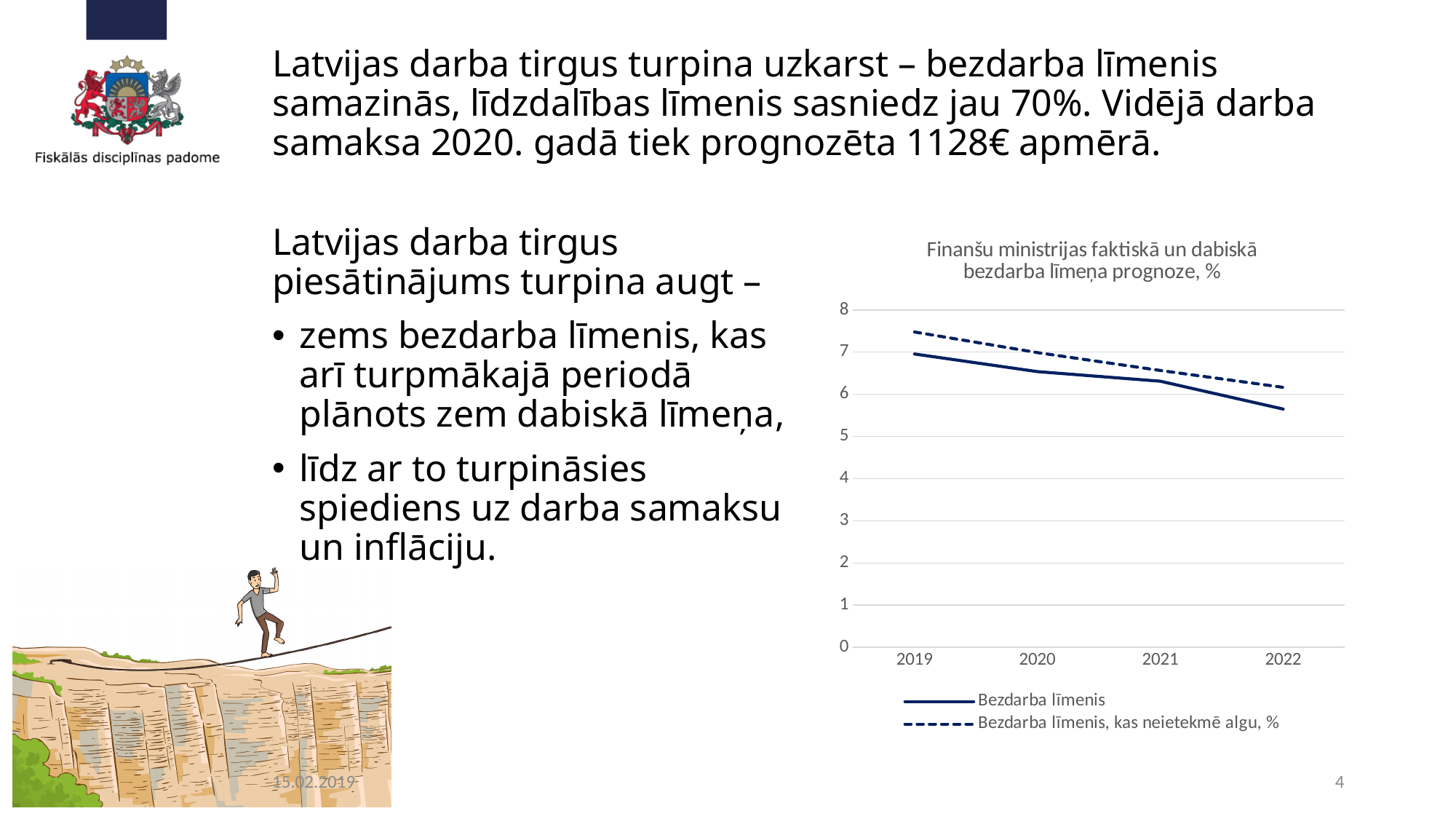
Is the value of 'Bezdarba līmenis, kas neietekmē algu, %' in 2019 greater or less than 7? greater What kind of chart is shown on the slide? line chart Is the value of 'Bezdarba līmenis' in 2022 greater or less than 6? less What is the title of the chart? Finanšu ministrijas faktiskā un dabiskā bezdarba līmeņa prognoze, % In which year is the 'Bezdarba līmenis' line at its lowest? 2022 In 2022, which series is higher: 'Bezdarba līmenis' or 'Bezdarba līmenis, kas neietekmē algu, %'? Bezdarba līmenis, kas neietekmē algu, % Is the value of 'Bezdarba līmenis' in 2020 greater or less than 6? greater In which year is the 'Bezdarba līmenis' line at its highest? 2019 Does the 'Bezdarba līmenis' line rise or fall from 2019 to 2022? fall How many series does the chart legend list? 2 How many years are shown on the x axis of the chart? 4 Does the 'Bezdarba līmenis, kas neietekmē algu, %' line rise or fall from 2019 to 2022? fall